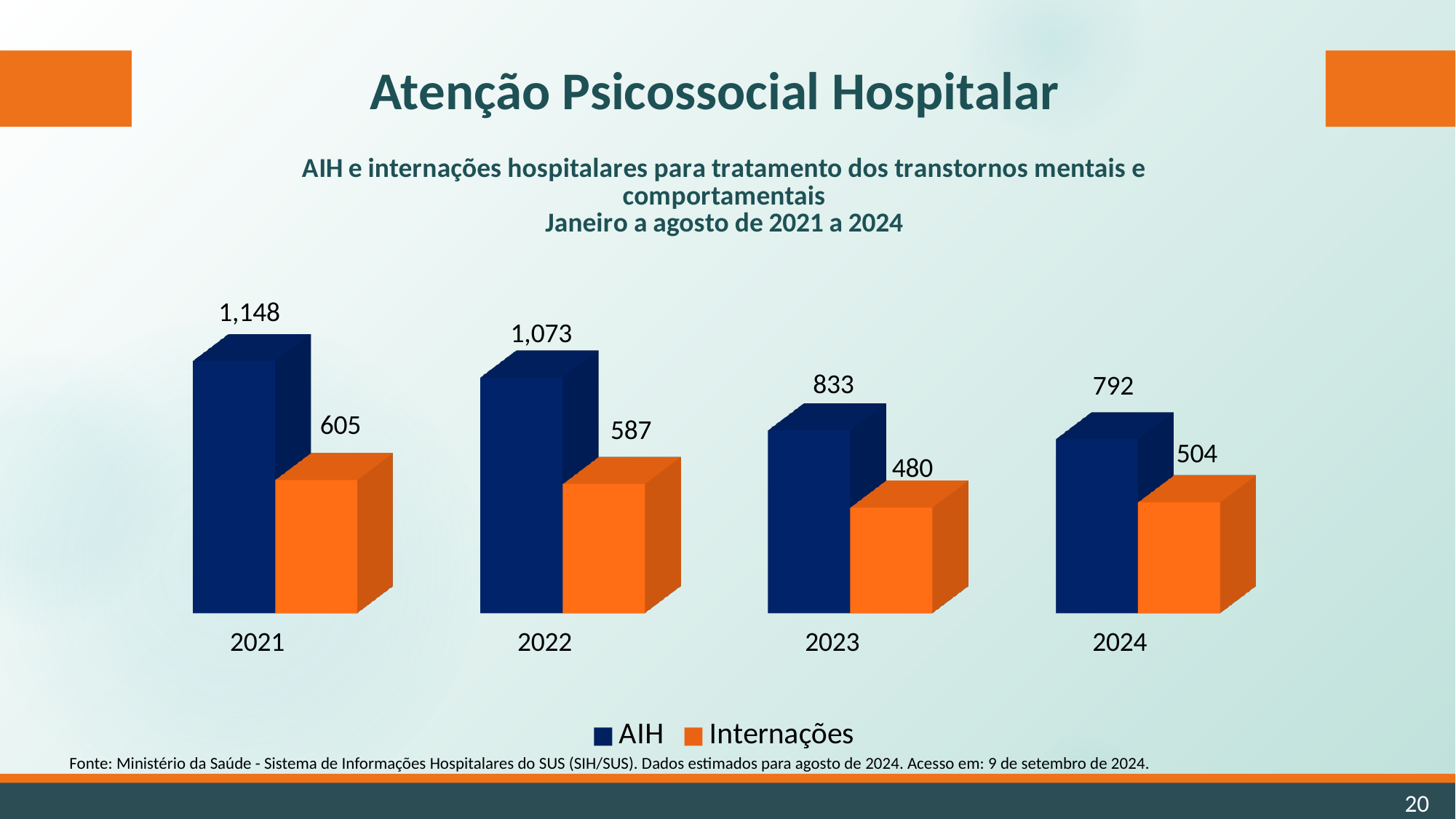
What kind of chart is shown on the slide? Bar chart How many series does the legend list? 2 Does the AIH value rise or fall from 2021 to 2024? Fall How many years are shown on the x axis? 4 Which year has the highest AIH value? 2021 What is the AIH value for 2021? 1,148 Which is larger, the Internações value for 2021 or for 2024? 2021 Which year has the lowest Internações value? 2023 Which colour represents the Internações series in the legend? Orange What is the AIH value for 2024? 792 What is the Internações value for 2023? 480 What is the difference between the AIH and Internações values in 2022? 486